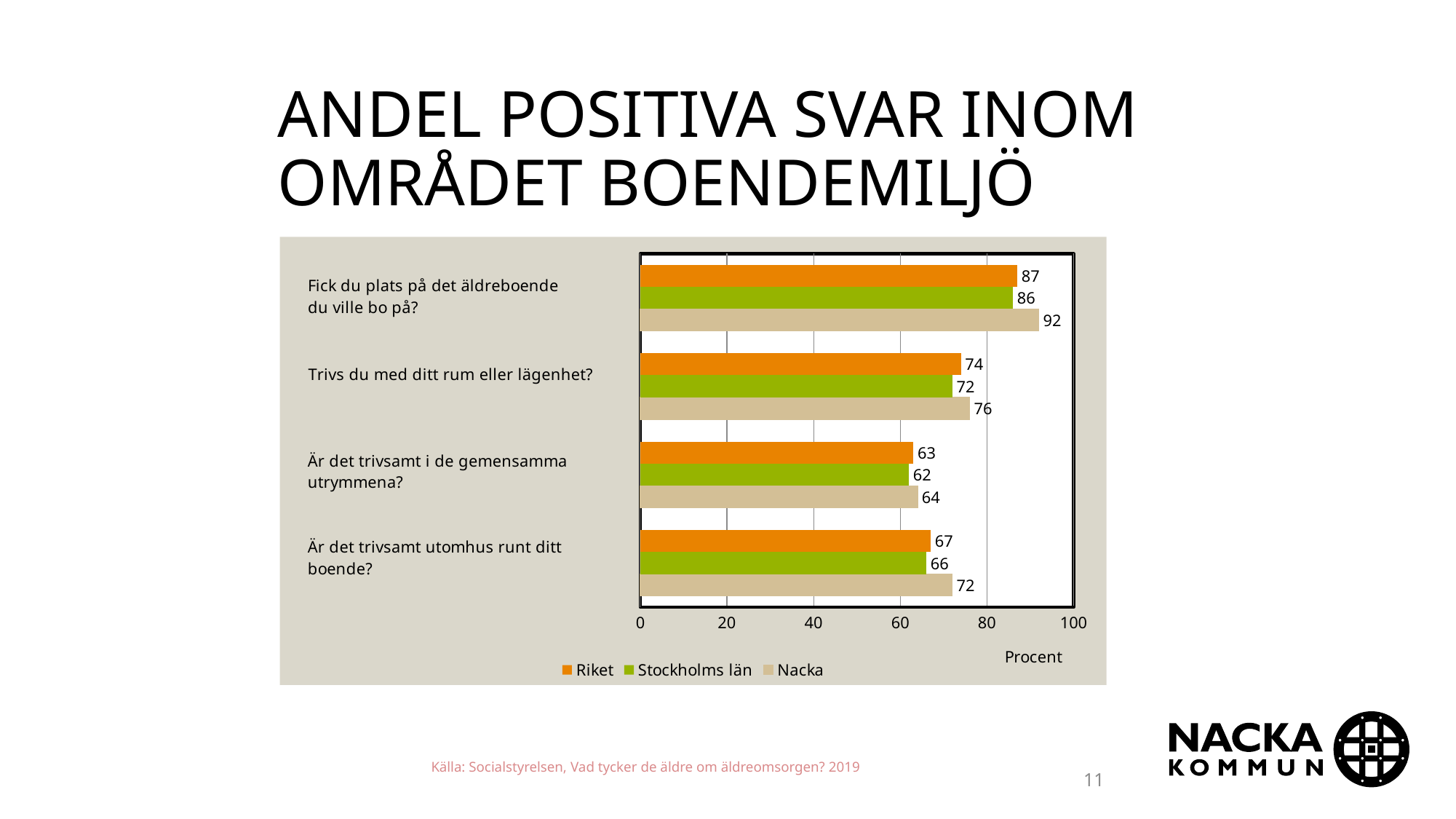
What is the Nacka value for "Är det trivsamt utomhus runt ditt boende?"? 72 What is the Riket value for "Trivs du med ditt rum eller lägenhet?"? 74 For "Trivs du med ditt rum eller lägenhet?", which is larger: the Nacka value or the Stockholms län value? Nacka How many questions (categories) are shown in the chart? 4 Which question has the lowest Riket value? Är det trivsamt i de gemensamma utrymmena? What is the Nacka value for "Fick du plats på det äldreboende du ville bo på?"? 92 What is the difference between the Nacka and Riket values for "Är det trivsamt utomhus runt ditt boende?"? 5 What is the Stockholms län value for "Är det trivsamt i de gemensamma utrymmena?"? 62 What is the label on the horizontal axis of the chart? Procent What kind of chart is shown on the slide? Bar chart Which question has the highest Nacka value? Fick du plats på det äldreboende du ville bo på? How many series does the legend list? 3